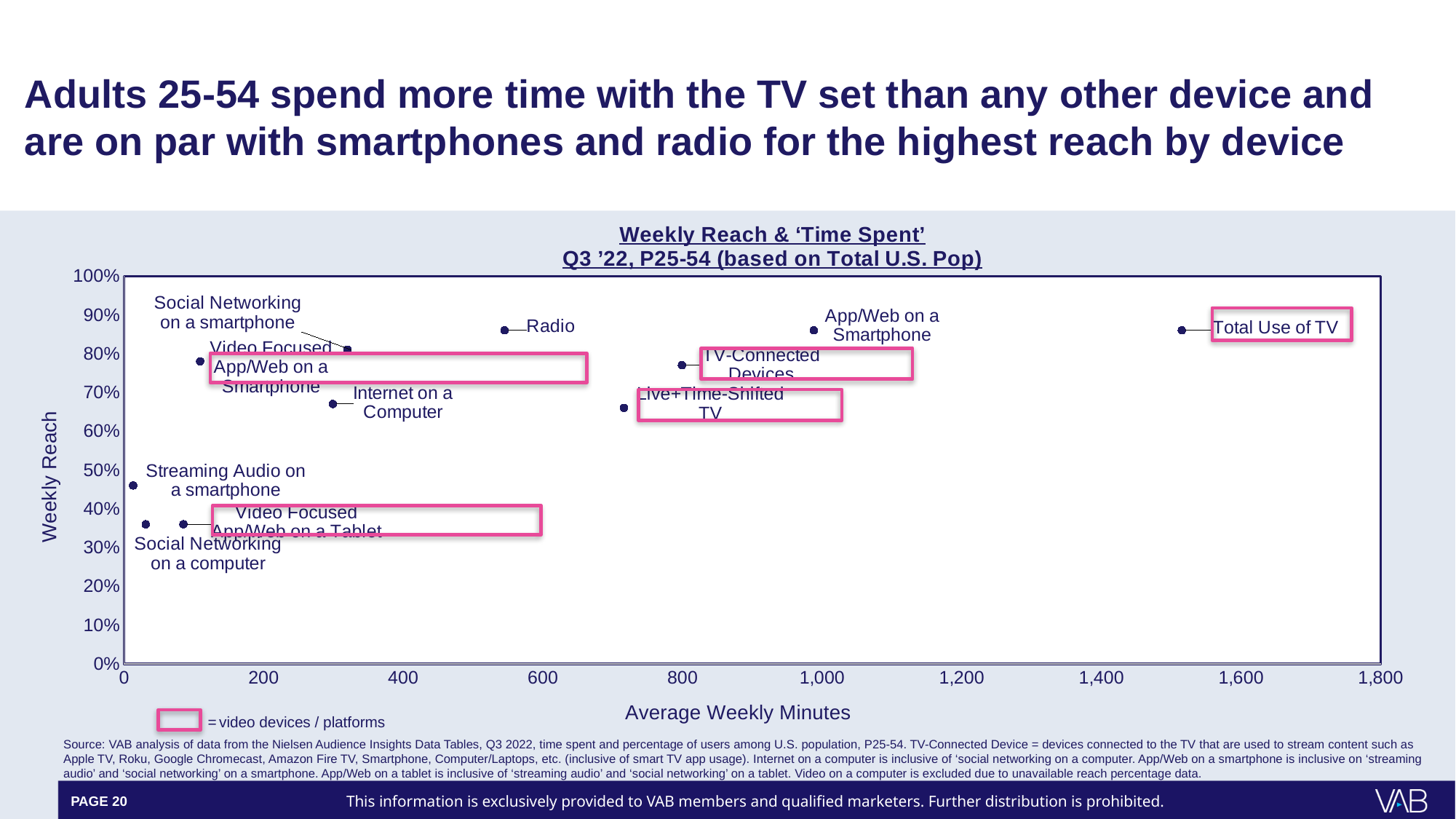
Which device/platform has the lowest Average Weekly Minutes? Streaming Audio on a smartphone Which device/platform has the highest Average Weekly Minutes? Total Use of TV Is the Weekly Reach for Streaming Audio on a smartphone greater or less than 50%? less Which has more Average Weekly Minutes, Total Use of TV or Radio? Total Use of TV What is the label of the horizontal axis of the chart? Average Weekly Minutes Is the Weekly Reach for Live+Time-Shifted TV greater or less than 70%? less How many data points are plotted on the chart? 11 Is the Average Weekly Minutes value for Total Use of TV greater or less than 1,400? greater What kind of chart is shown on the slide? Scatter chart Which has a higher Weekly Reach, Radio or Streaming Audio on a smartphone? Radio